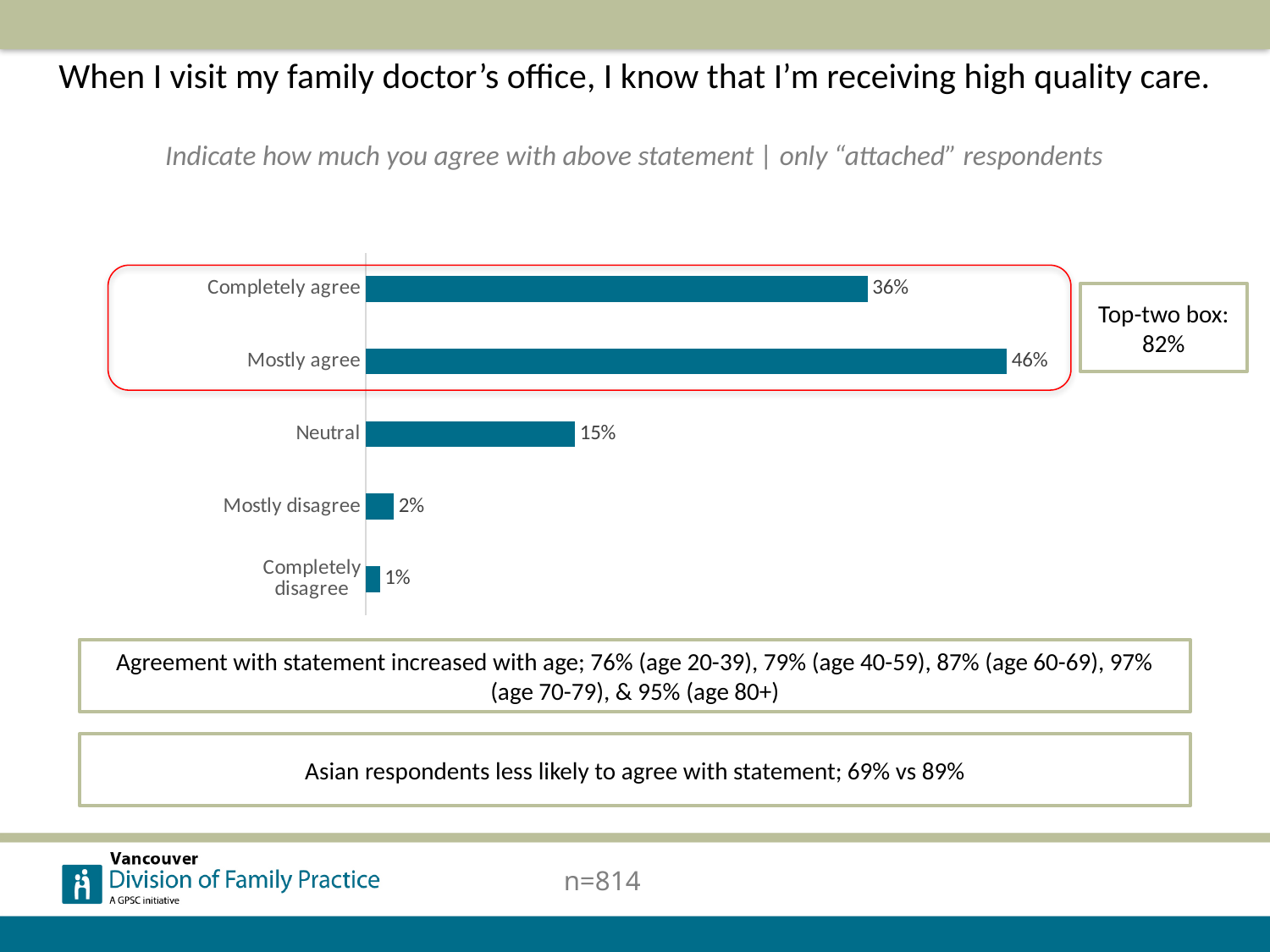
Which is larger, the percentage for Neutral or for Mostly disagree? Neutral What percentage of respondents mostly agree with the statement? 46% What percentage of respondents are neutral? 15% What percentage of respondents completely agree with the statement? 36% What is the combined percentage of Completely agree and Mostly agree? 82% Which response category has the highest percentage? Mostly agree What percentage of respondents completely disagree? 1% What is the top-two box percentage shown in the callout box? 82% How many response categories are shown in the chart? 5 Which response category has the lowest percentage? Completely disagree What is the difference in percentage points between Mostly agree and Completely agree? 10 What kind of chart is shown on the slide? Bar chart